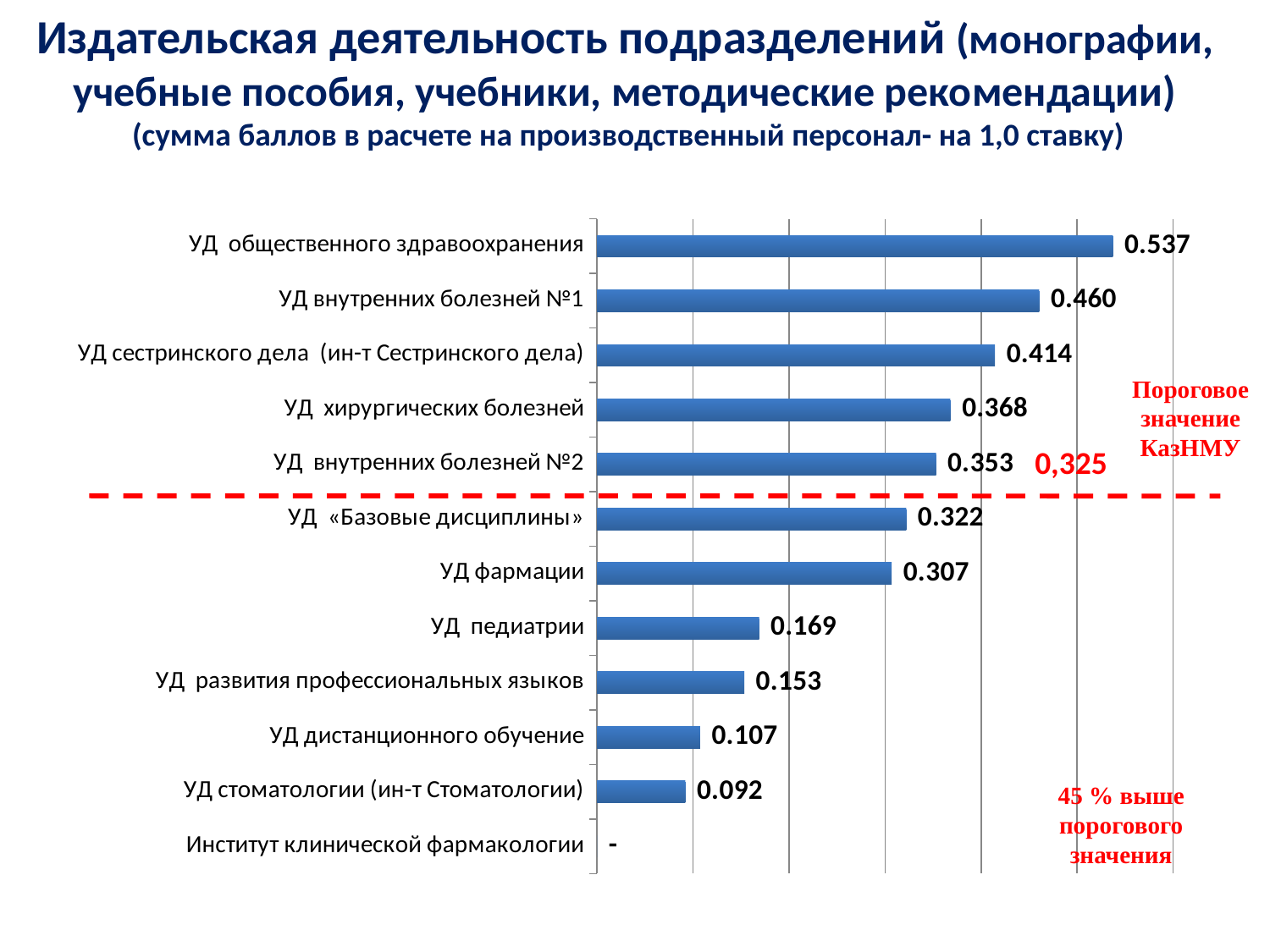
What is the value for УД сестринского дела (ин-т Сестринского дела)? 0.414 What is the value for УД общественного здравоохранения? 0.537 What is the value for УД дистанционного обучение? 0.107 What threshold value (Пороговое значение КазНМУ) is marked by the red dashed line? 0,325 Which is larger: the value for УД педиатрии or the value for УД развития профессиональных языков? УД педиатрии How many departments are listed on the chart? 12 What is the difference between the values for УД общественного здравоохранения and УД внутренних болезней №1? 0.077 What type of chart is shown on the slide? bar chart Among the departments with a numeric value shown, which has the lowest value? УД стоматологии (ин-т Стоматологии) Which department has the highest value? УД общественного здравоохранения How many departments are above the red dashed threshold line? 5 What is the value for УД фармации? 0.307